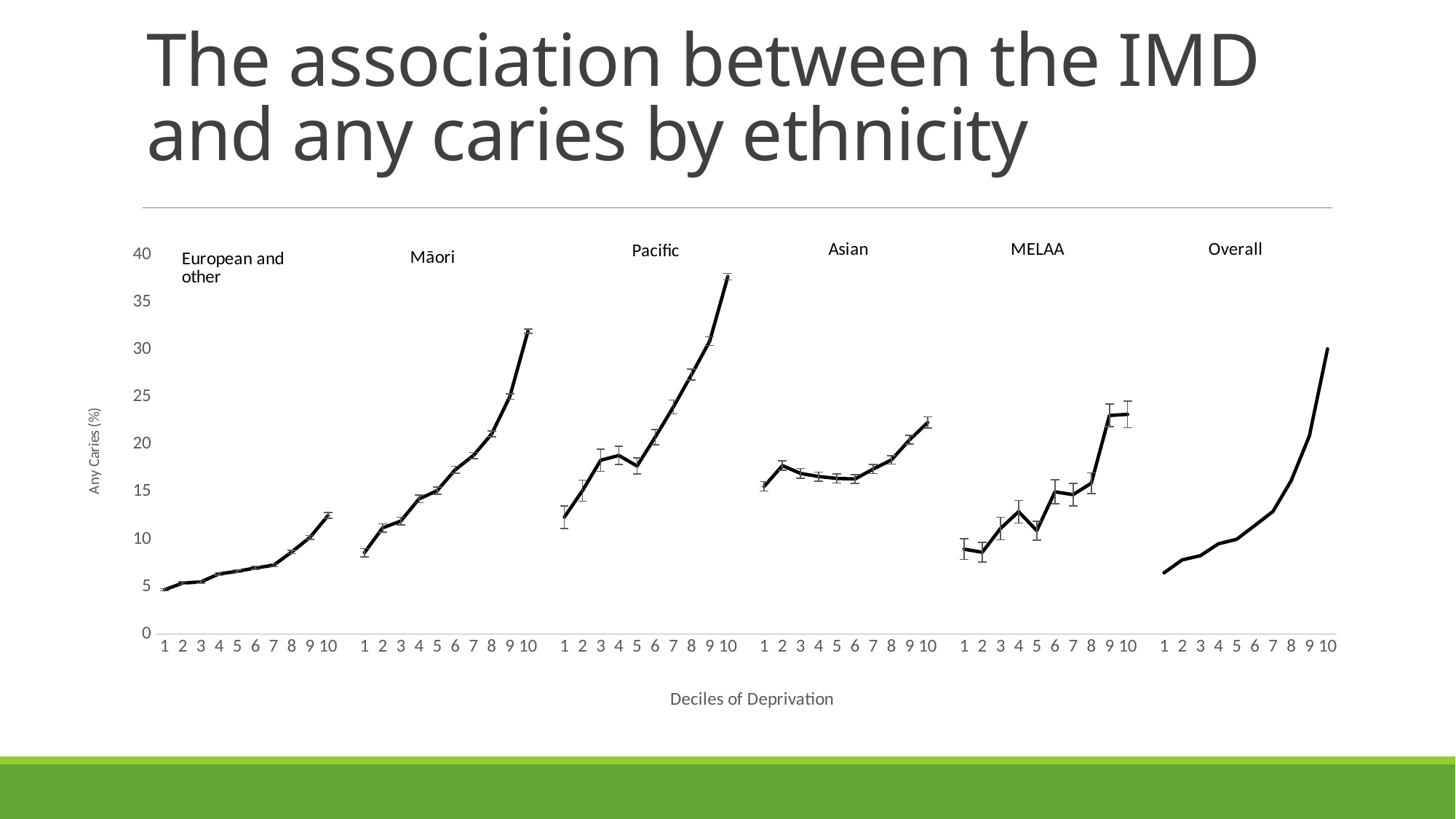
Is the European and other value at decile 1 greater or less than 10? less What is the label of the x axis? Deciles of Deprivation Which group has the lowest value of any caries at decile 10? European and other Is the Pacific value at decile 10 greater or less than 35? greater What kind of chart is shown on the slide? Line chart Which group has the highest value of any caries at decile 10? Pacific How many deciles of deprivation are shown on the x axis for each group? 10 How many ethnic groups (panels) are plotted in the chart? 6 Is the Māori value at decile 10 greater or less than 30? greater Which is larger at decile 10: the Asian value or the Māori value? Māori What is the label of the y axis? Any Caries (%) Do the values for the Overall group rise or fall as the deciles of deprivation increase from 1 to 10? Rise